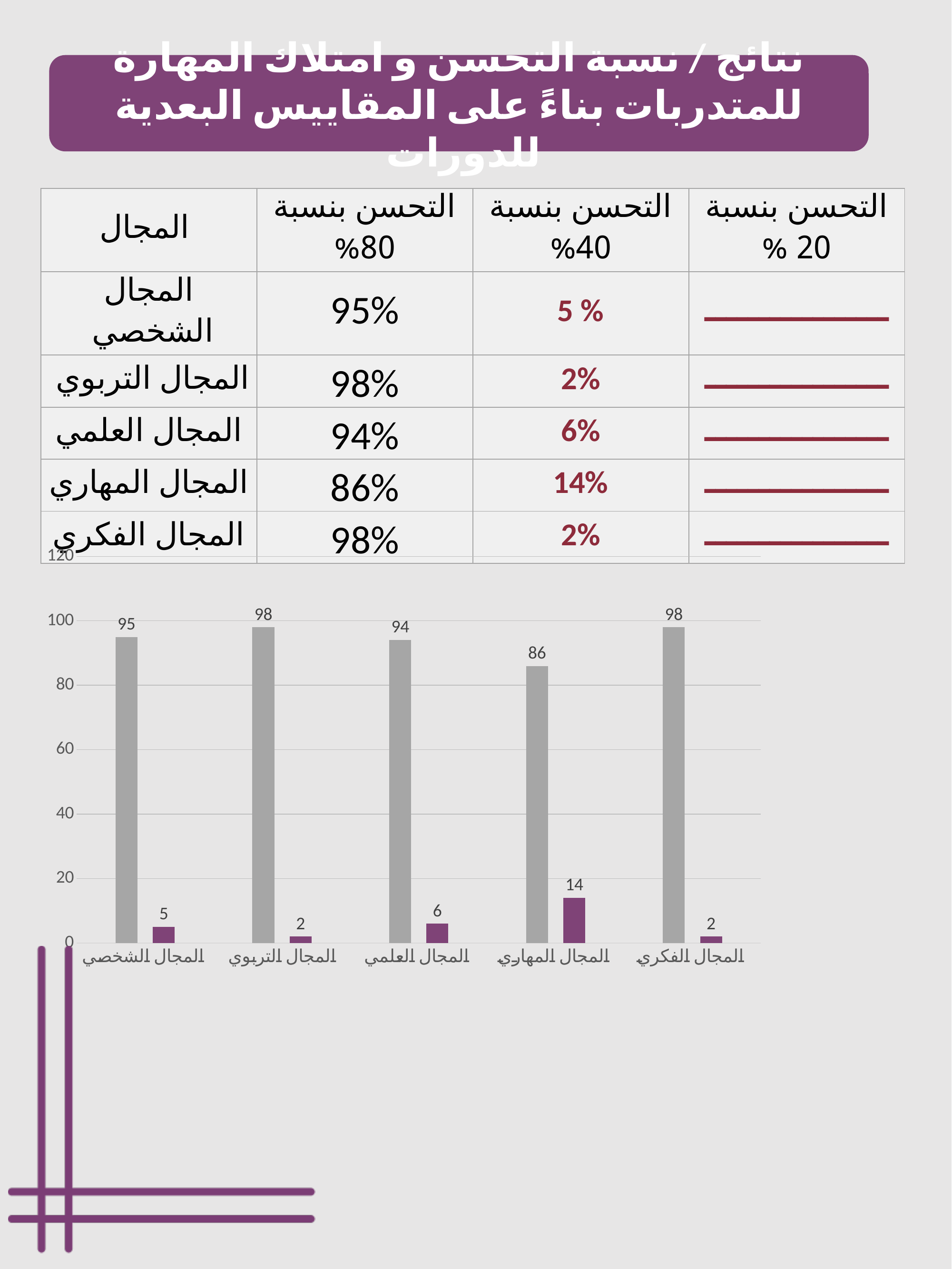
Which category has the lowest gray bar? المجال المهاري What is the difference between the gray bar values for المجال التربوي and المجال المهاري? 12 What is the value of the purple bar for المجال التربوي? 2 What is the value of the purple bar for المجال المهاري? 14 Which category has the highest purple bar? المجال المهاري Which is larger: the purple bar for المجال العلمي or the purple bar for المجال الشخصي? المجال العلمي What is the highest tick value shown on the vertical axis of the chart? 120 Is the gray bar value for المجال المهاري greater or less than 80? greater How many categories are shown on the x axis of the chart? 5 What type of chart is shown on the slide? bar chart What is the value of the gray bar for المجال الشخصي? 95 What is the value of the gray bar for المجال العلمي? 94